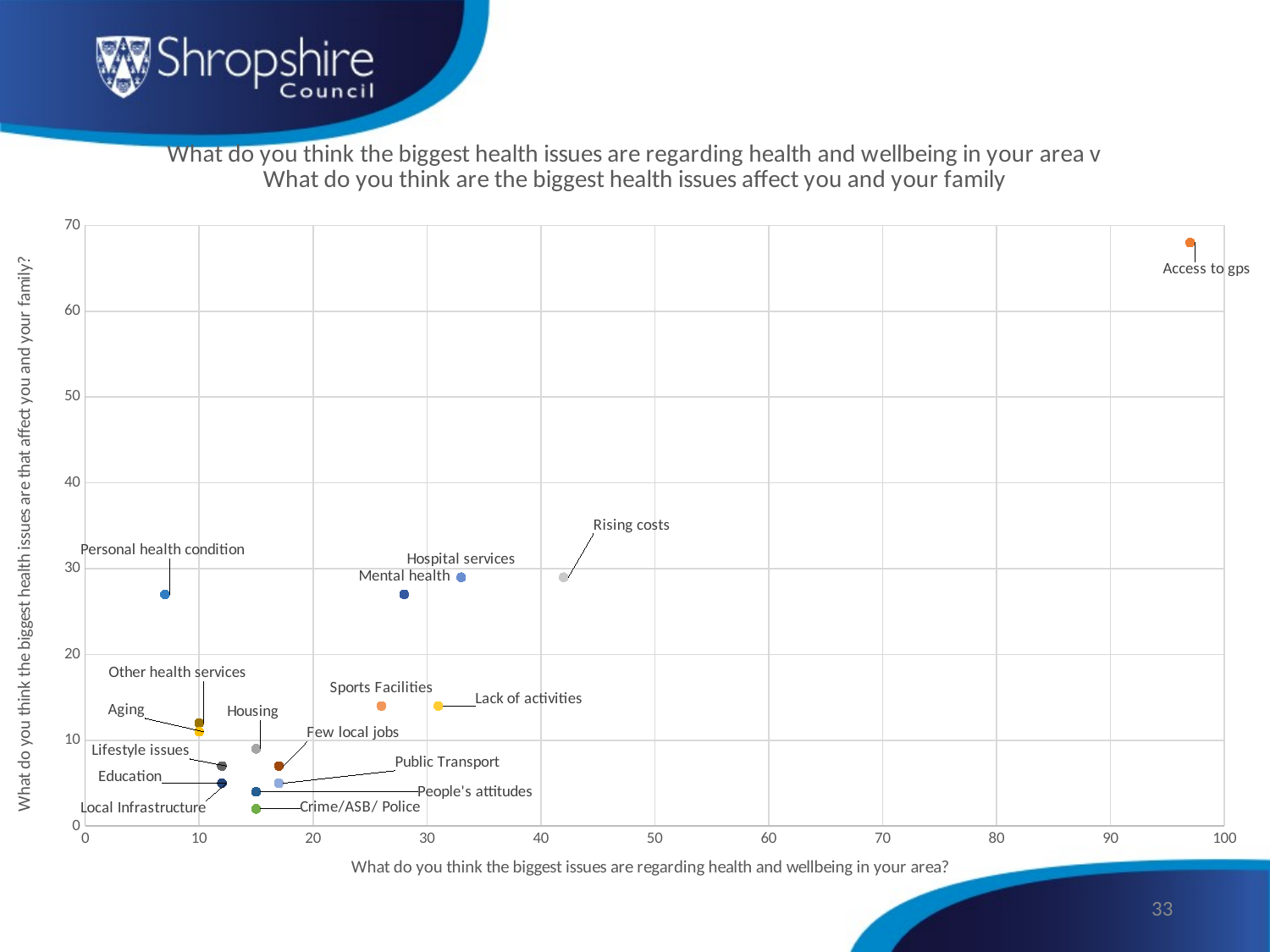
Which labelled point has the highest value on the horizontal axis (biggest issues in your area)? Access to gps What is the title of the horizontal axis? What do you think the biggest issues are regarding health and wellbeing in your area? What is the highest tick value shown on the vertical axis? 70 Is the horizontal-axis value for Personal health condition greater or less than 10? less What kind of chart is shown on the slide? scatter chart Which has the larger vertical-axis value, Mental health or Sports Facilities? Mental health Which has the larger horizontal-axis value, Rising costs or Hospital services? Rising costs Is the horizontal-axis value for Rising costs greater or less than 30? greater Which labelled point has the highest value on the vertical axis (issues affecting you and your family)? Access to gps Which labelled point has the lowest value on the vertical axis? Crime/ASB/ Police Is the vertical-axis value for Lack of activities greater or less than 20? less